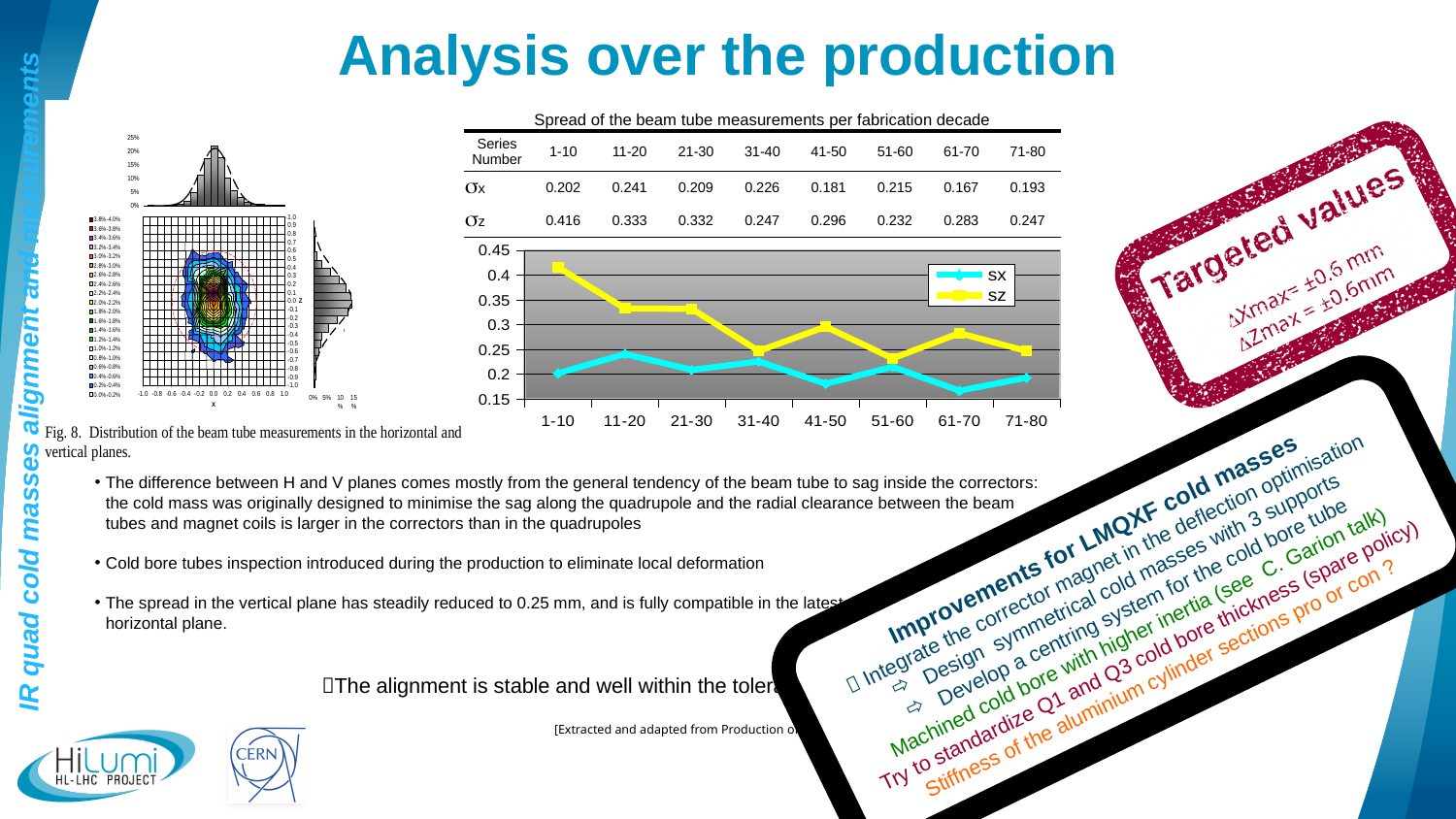
In the line chart 'Spread of the beam tube measurements per fabrication decade', which is larger for series 31-40, SX or SZ? SZ How many series numbers (fabrication decades) are plotted on the x axis of the line chart 'Spread of the beam tube measurements per fabrication decade'? 8 In the line chart 'Spread of the beam tube measurements per fabrication decade', what is the SX value for series 41-50? 0.181 In the line chart 'Spread of the beam tube measurements per fabrication decade', what is the SZ value for series 71-80? 0.247 In the line chart 'Spread of the beam tube measurements per fabrication decade', is the SZ value for series 1-10 greater or less than 0.4? greater In the line chart 'Spread of the beam tube measurements per fabrication decade', which series number has the highest SX value? 11-20 What kind of chart is 'Spread of the beam tube measurements per fabrication decade'? line chart In the line chart 'Spread of the beam tube measurements per fabrication decade', what is the SZ value for series 1-10? 0.416 In the line chart 'Spread of the beam tube measurements per fabrication decade', which series number has the highest SZ value? 1-10 In the line chart 'Spread of the beam tube measurements per fabrication decade', what is the difference between the SZ and SX values for series 1-10? 0.214 In the line chart 'Spread of the beam tube measurements per fabrication decade', which series number has the lowest SX value? 61-70 How many series does the legend of the line chart 'Spread of the beam tube measurements per fabrication decade' list? 2